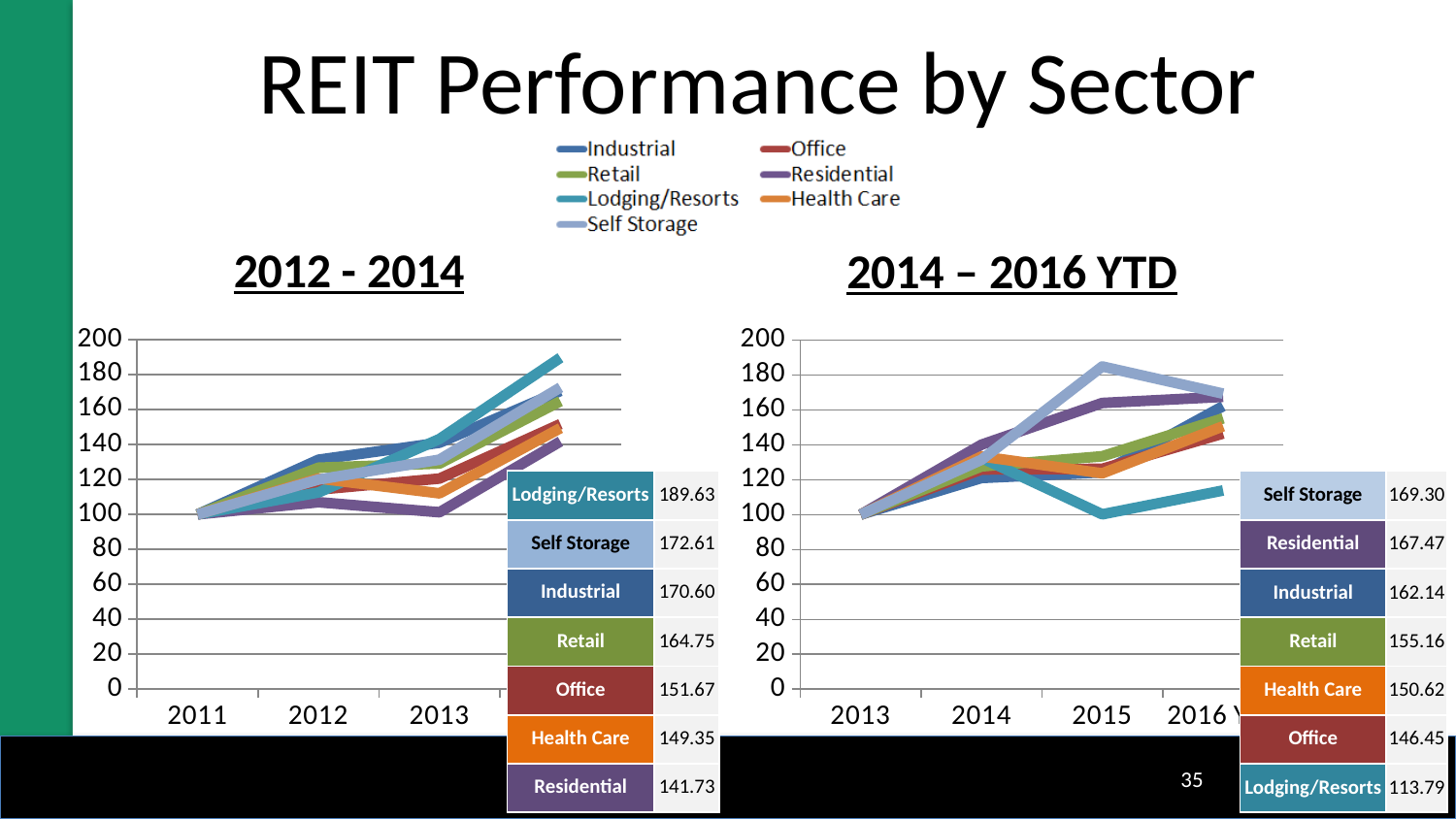
In the 2012 - 2014 chart, what is the final value shown for Lodging/Resorts? 189.63 In the 2014 – 2016 YTD chart, which has the larger final value, Residential or Office? Residential In the 2012 - 2014 chart, which sector has the highest final value in the table? Lodging/Resorts In the 2012 - 2014 chart, does the Lodging/Resorts line rise or fall from 2011 to the end of the period? rise What type of chart is used on the slide for the 2012 - 2014 and 2014 – 2016 YTD panels? line chart In the 2012 - 2014 chart, what is the difference between the final values of Industrial and Retail? 5.85 In the 2014 – 2016 YTD chart, is the value for Lodging/Resorts in 2015 greater or less than 120? less In the 2012 - 2014 chart, which sector has the lowest final value in the table? Residential How many series does the legend list? 7 In the 2014 – 2016 YTD chart, which sector has the lowest final value in the table? Lodging/Resorts In the 2014 – 2016 YTD chart, what is the difference between the final values of Self Storage and Lodging/Resorts? 55.51 In the 2014 – 2016 YTD chart, what is the final value shown for Self Storage? 169.30